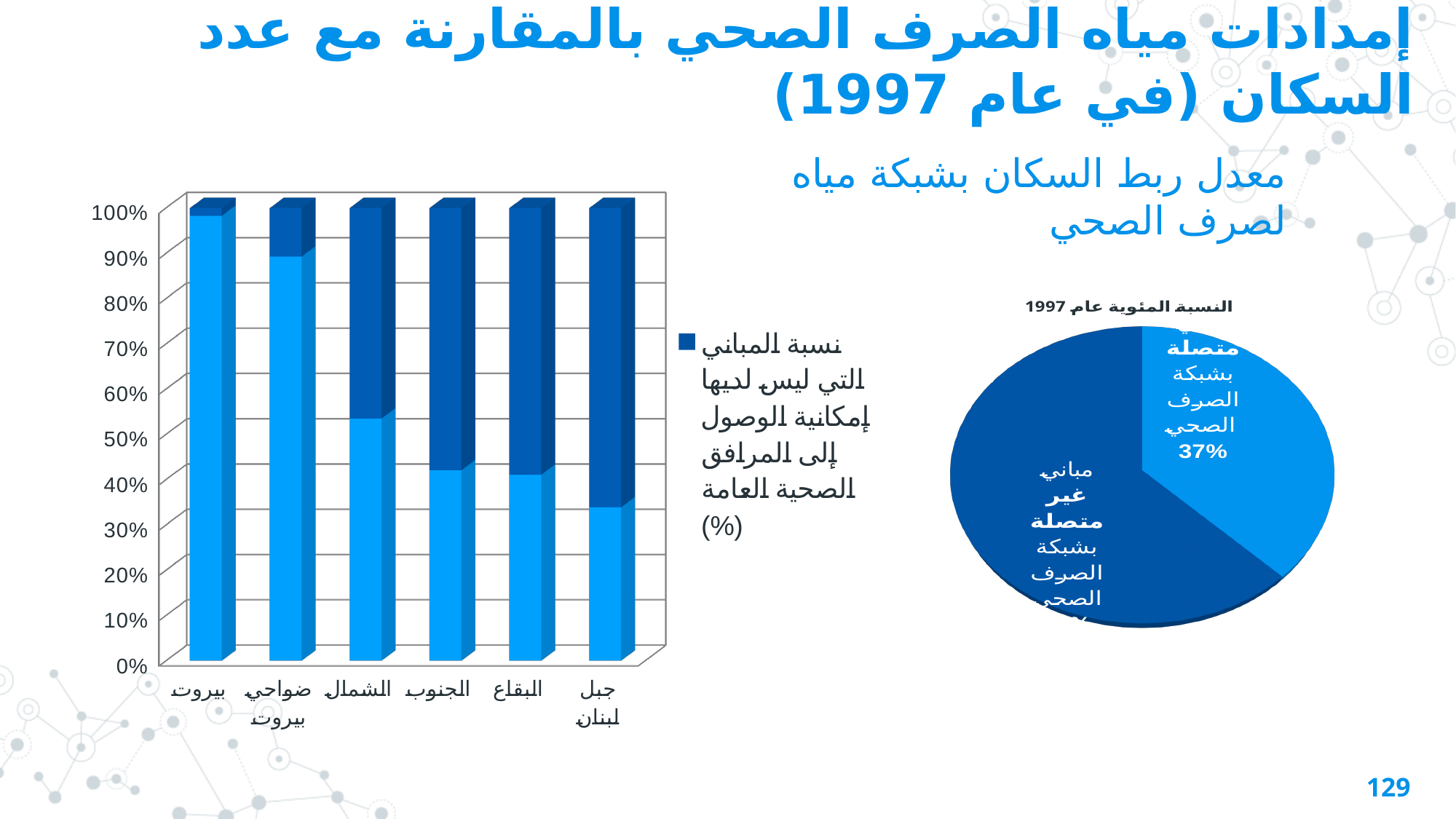
How many series does the legend of the bar chart on the left list? 1 What kind of chart is the chart on the left of the slide? bar chart In the bar chart on the left, is the light blue value for الشمال greater or less than 60%? less In the bar chart on the left, which category has the lowest light blue value? جبل لبنان In the bar chart on the left, is the light blue value for جبل لبنان greater or less than 40%? less In the pie chart on the right, what share is shown for مباني متصلة بشبكة الصرف الصحي? 37% In the bar chart on the left, which category has the highest light blue value? بيروت In the bar chart on the left, which has the larger light blue value, بيروت or الشمال? بيروت In the bar chart on the left, is the light blue value for ضواحي بيروت greater or less than 80%? greater What is the title of the pie chart on the right? النسبة المئوية عام 1997 How many categories are shown on the x axis of the bar chart on the left? 6